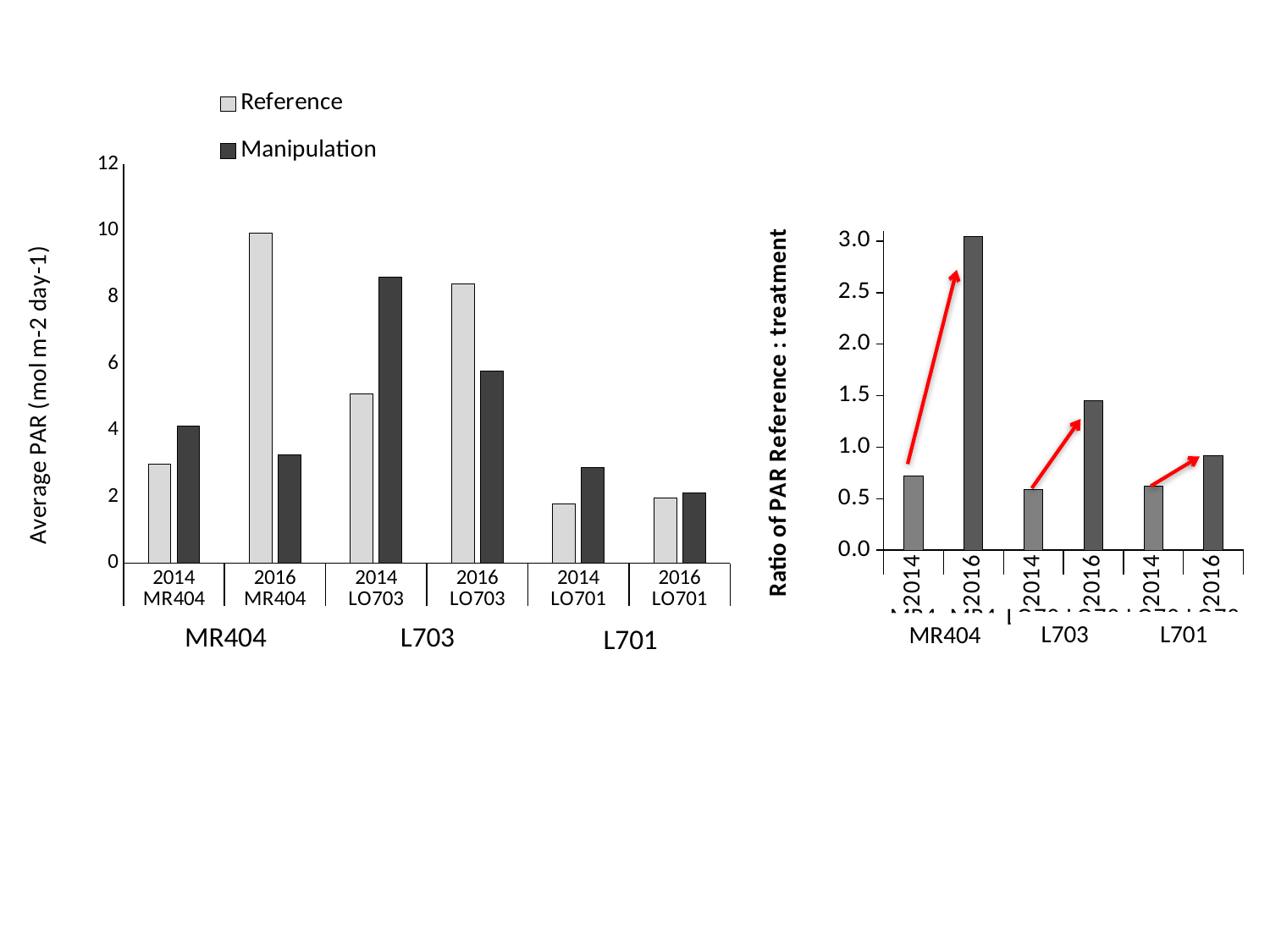
In the right chart (Ratio of PAR Reference : treatment), is the value for 2014 MR404 greater or less than 1.0? less In the left chart (Average PAR), is the Manipulation value for 2014 LO703 greater or less than 8? greater What is the y-axis label of the left chart? Average PAR (mol m-2 day-1) In the left chart (Average PAR), is the Reference value for 2016 MR404 greater or less than 8? greater How many series does the legend of the left chart (Average PAR) list? 2 How many categories are shown on the x axis of the left chart (Average PAR)? 6 In the left chart (Average PAR), which is larger for 2016 LO703, Reference or Manipulation? Reference What kind of chart is the left chart (Average PAR)? bar chart In the left chart (Average PAR), which category has the highest Reference bar? 2016 MR404 In the left chart (Average PAR), which category has the lowest Manipulation bar? 2016 LO701 In the right chart (Ratio of PAR Reference : treatment), which bar is the highest? 2016 MR404